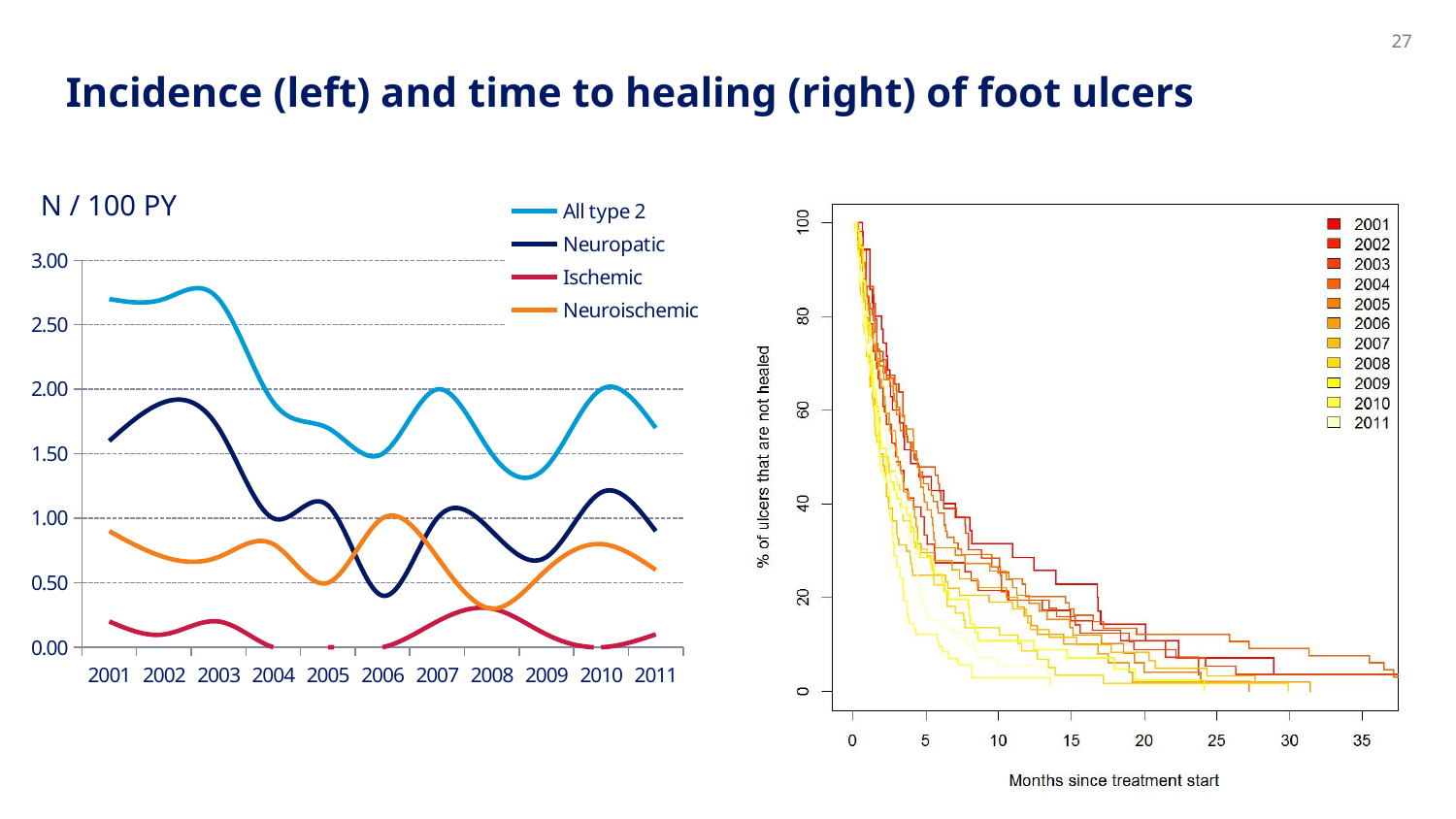
On the left chart, does the All type 2 series overall rise or fall from 2001 to 2011? fall On the left chart, how many series does the legend list? 4 On the left chart, is the value for Neuropatic in 2006 greater or less than 0.50? less On the left chart, how many years are shown on the x axis? 11 On the left chart, in which year is the Neuropatic series at its highest? 2002 On the left chart, in 2006, which is larger: Neuropatic or Neuroischemic? Neuroischemic On the right chart, how many years does the legend list? 11 What kind of chart is the left chart? Line chart On the left chart, is the value for All type 2 in 2001 greater or less than 2.50? greater What is the x-axis label of the right chart? Months since treatment start On the left chart, is the value for All type 2 in 2009 greater or less than 1.50? less On the left chart, in which year is the Neuropatic series at its lowest? 2006